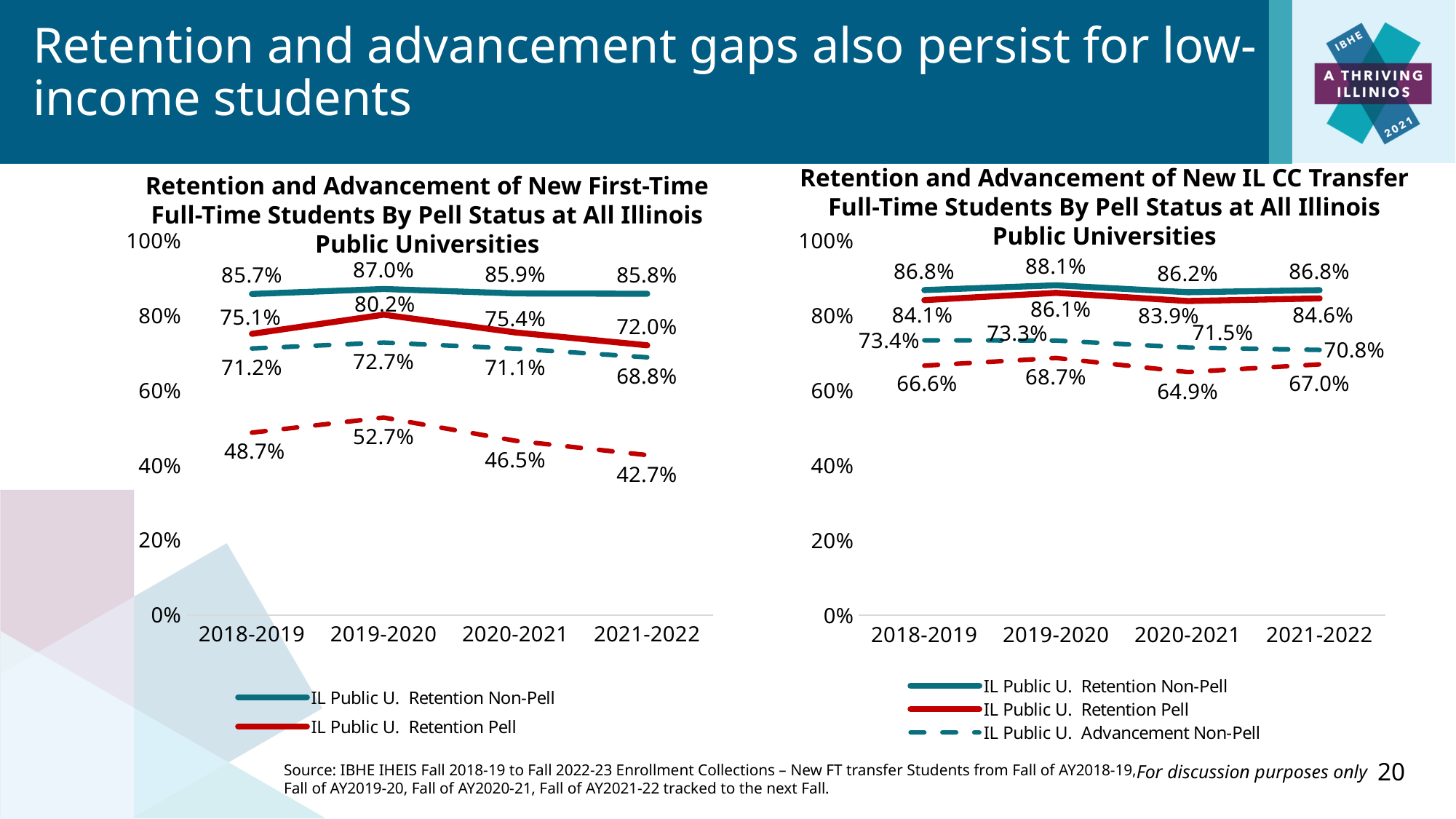
What type of chart is the left chart (New First-Time Full-Time Students)? Line chart In the right chart (New IL CC Transfer Full-Time Students), what is the IL Public U. Advancement Non-Pell value for 2020-2021? 71.5% In the left chart (New First-Time Full-Time Students), what is the difference between the IL Public U. Retention Non-Pell and Retention Pell values in 2021-2022? 13.8% In the left chart (New First-Time Full-Time Students), in which year is the IL Public U. Retention Non-Pell value highest? 2019-2020 In the left chart (New First-Time Full-Time Students), what is the IL Public U. Retention Non-Pell value for 2021-2022? 85.8% In the left chart (New First-Time Full-Time Students), what is the IL Public U. Retention Pell value for 2019-2020? 80.2% In the right chart (New IL CC Transfer Full-Time Students), what is the IL Public U. Retention Pell value for 2018-2019? 84.1% In the left chart (New First-Time Full-Time Students), which is larger in 2020-2021: the IL Public U. Retention Pell value or the Advancement Non-Pell value? IL Public U. Retention Pell In the right chart (New IL CC Transfer Full-Time Students), what is the difference between the IL Public U. Retention Non-Pell and Retention Pell values in 2019-2020? 2.0% In the right chart (New IL CC Transfer Full-Time Students), in which year is the IL Public U. Advancement Non-Pell value lowest? 2021-2022 How many series does the legend of the right chart (New IL CC Transfer Full-Time Students) list? 3 How many years are shown on the x axis of the right chart (New IL CC Transfer Full-Time Students)? 4